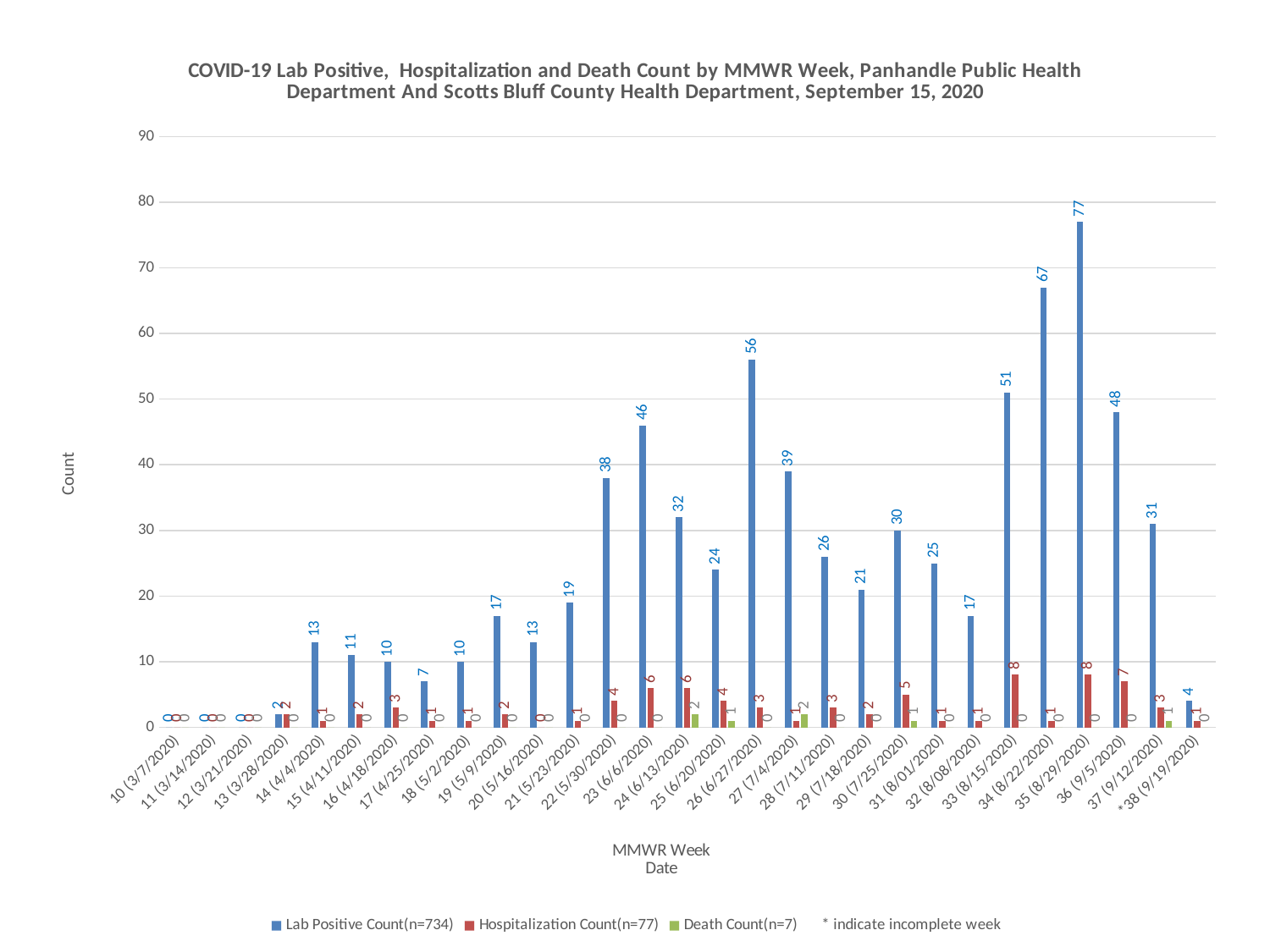
Does the Lab Positive Count rise or fall from week 33 (8/15/2020) to week 35 (8/29/2020)? Rise Which MMWR week has the highest Lab Positive Count? 35 (8/29/2020) What is the Lab Positive Count for MMWR week 35 (8/29/2020)? 77 How many MMWR weeks are shown on the x axis? 29 What total n is given for the Hospitalization Count series in the legend? n=77 What is the Lab Positive Count for MMWR week 26 (6/27/2020)? 56 How many series does the legend list? 3 What is the Death Count for MMWR week 24 (6/13/2020)? 2 What is the Hospitalization Count for MMWR week 23 (6/6/2020)? 6 What is the difference between the Lab Positive Count for week 35 (8/29/2020) and week 34 (8/22/2020)? 10 What kind of chart is shown on the slide? Bar chart Which is larger, the Lab Positive Count for week 22 (5/30/2020) or for week 23 (6/6/2020)? 23 (6/6/2020)